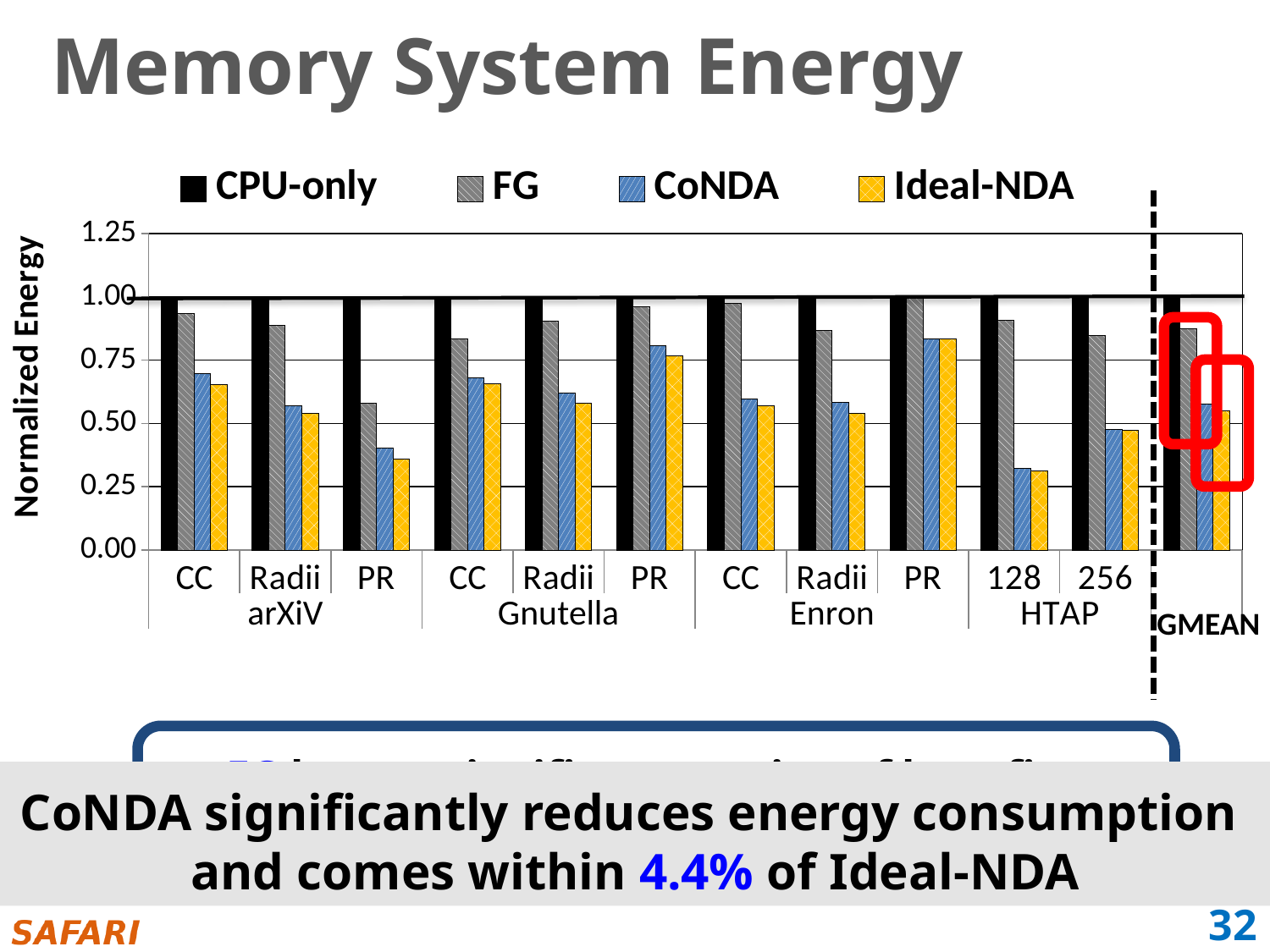
For arXiV CC, which is larger, the FG value or the CoNDA value? FG Is the Ideal-NDA value for Enron PR greater or less than 0.75? greater Is the FG value for Gnutella CC greater or less than 0.75? greater What is the normalized energy value for CPU-only in the GMEAN group? 1.00 What is the label of the y axis? Normalized Energy How many category groups are plotted along the x axis, including GMEAN? 12 Which is larger, the Ideal-NDA value for arXiV PR or the Ideal-NDA value for HTAP 256? HTAP 256 What kind of chart is shown on the slide? bar chart How many series does the legend list? 4 Is the CoNDA value for HTAP 128 greater or less than 0.50? less Which category group has the lowest CoNDA value? HTAP 128